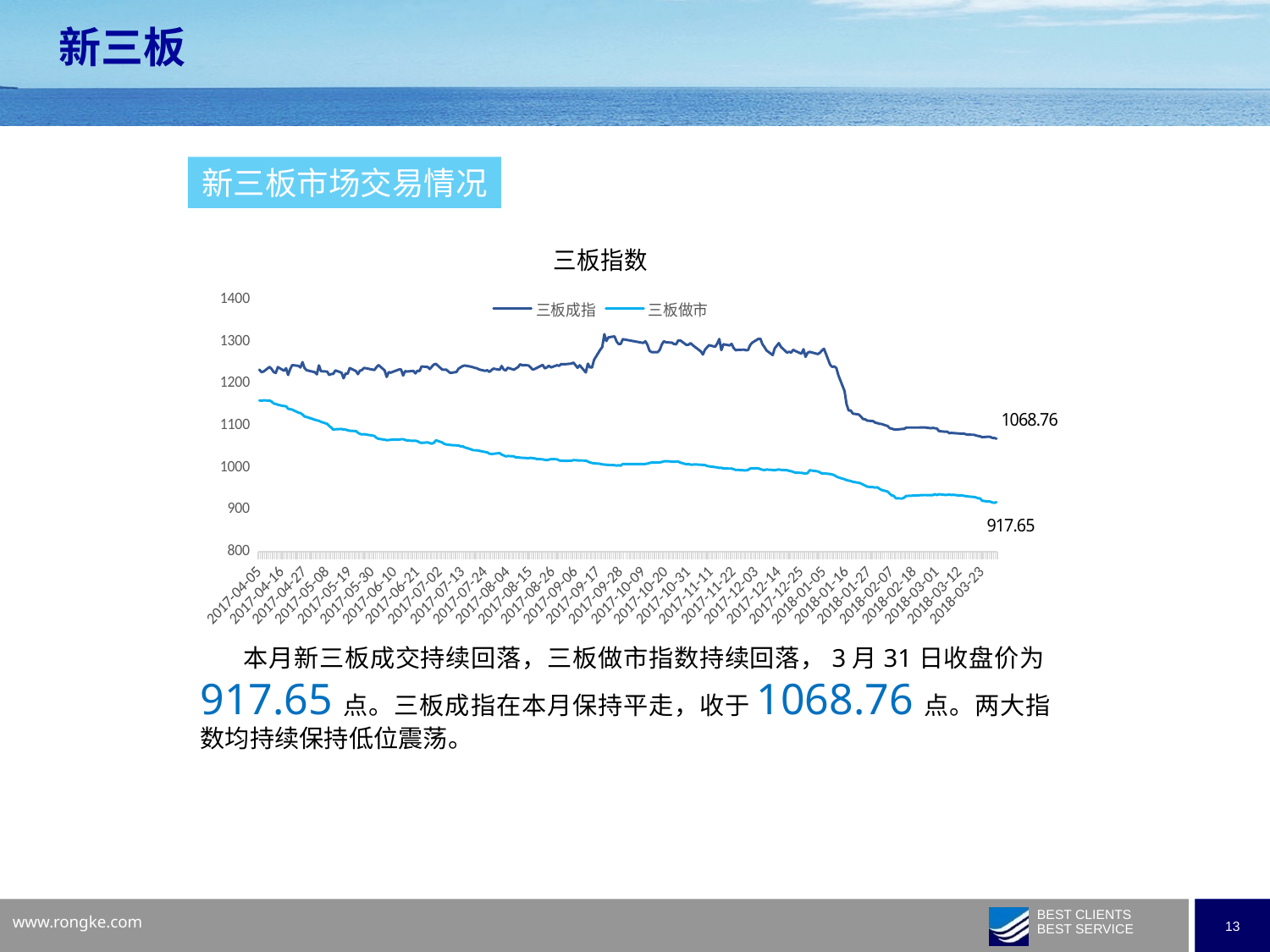
Which series ends at a higher value, 三板成指 or 三板做市? 三板成指 Is the value of 三板做市 at 2017-04-05 greater or less than 1200? less How many series does the legend list? 2 Is the value of 三板成指 at 2017-04-05 greater or less than 1200? greater What is the difference between the final labelled values of 三板成指 (1068.76) and 三板做市 (917.65)? 151.11 What is the final labelled value of the 三板做市 series? 917.65 What kind of chart is shown on the slide? line chart What is the final labelled value of the 三板成指 series? 1068.76 What is the title of the chart? 三板指数 Which series is drawn in the lighter blue line? 三板做市 Is the value of 三板做市 at 2018-03-23 greater or less than 1000? less Does the 三板做市 series generally rise or fall from 2017-04-05 to 2018-03-23? fall